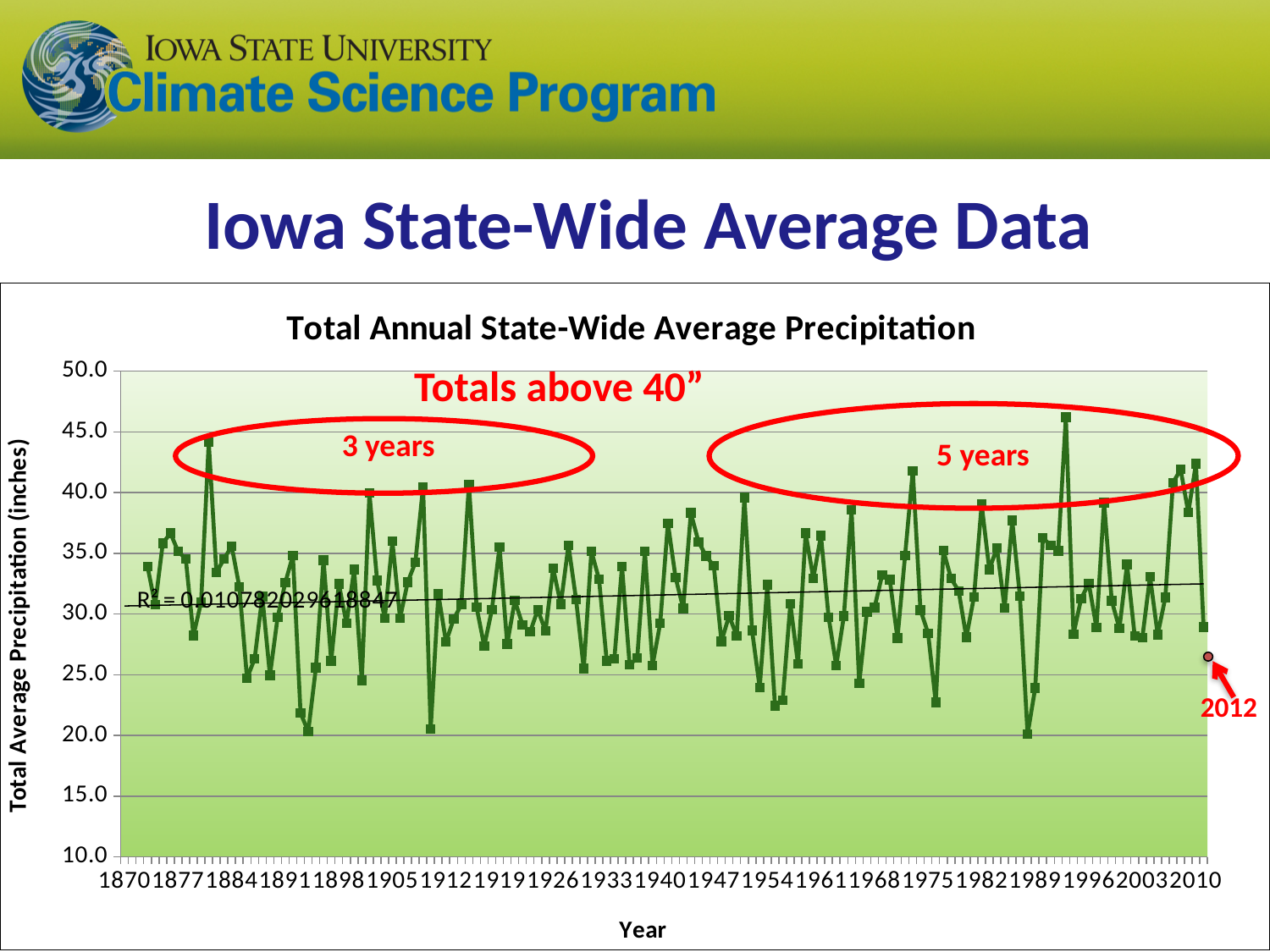
Is the lowest value on the chart greater or less than 25? less Is the highest value on the chart greater or less than 40? greater What is the first year shown on the x axis? 1870 Is the value for 2012 greater or less than 20? greater What is the label on the vertical axis of the chart? Total Average Precipitation (inches) According to the annotation, how many years in the first circled period had totals above 40 inches? 3 years What kind of chart is shown on the slide? Line chart What is the highest value shown on the y axis? 50.0 What is the title of the chart? Total Annual State-Wide Average Precipitation Does the fitted trend line rise or fall from left to right across the chart? rises According to the annotation, how many years in the second circled period had totals above 40 inches? 5 years